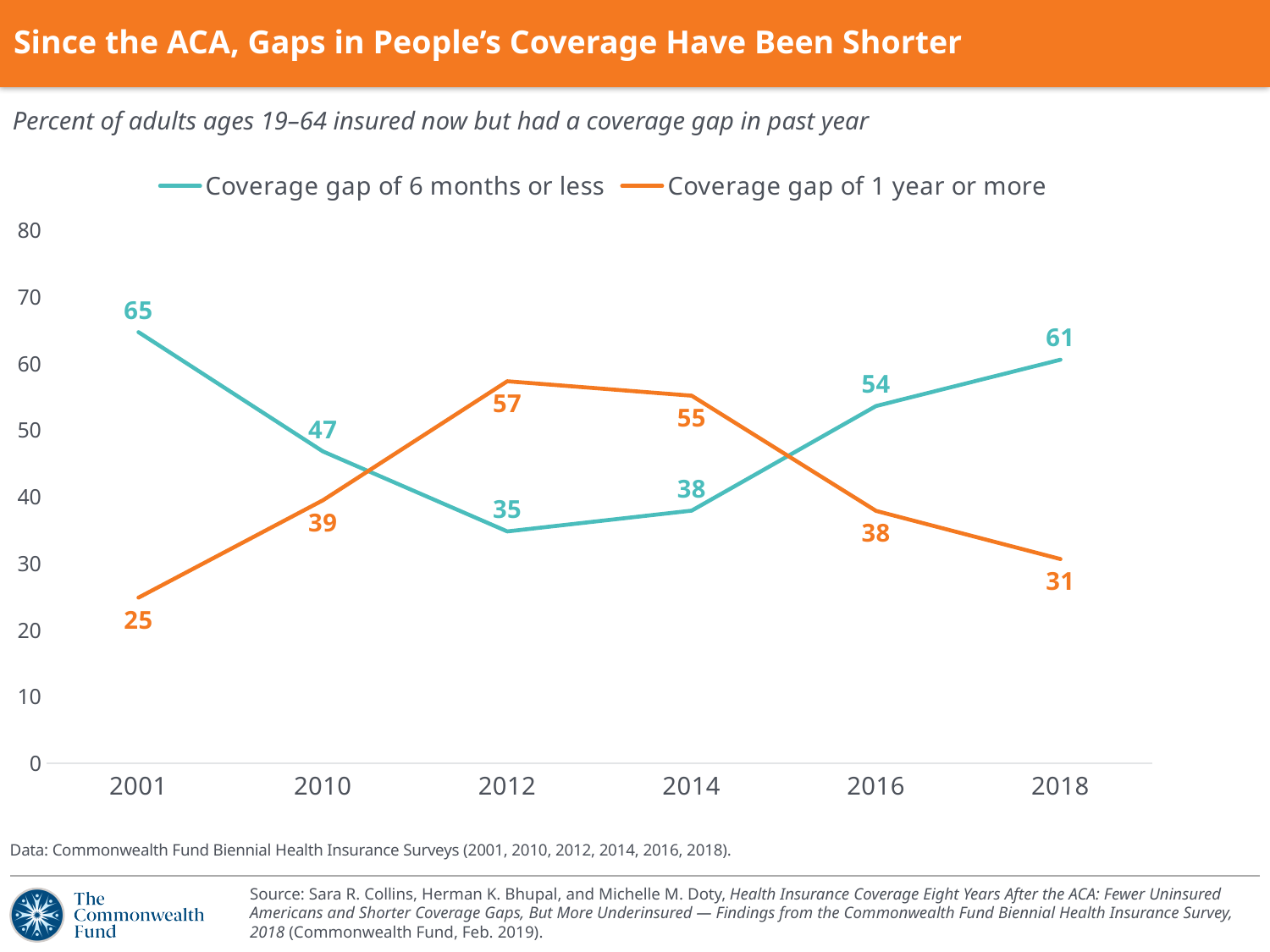
In which year is 'Coverage gap of 1 year or more' highest? 2012 What is the value for 'Coverage gap of 6 months or less' in 2018? 61 Which series has the larger value in 2014? Coverage gap of 1 year or more What kind of chart is shown on the slide? Line chart What is the difference between 'Coverage gap of 6 months or less' and 'Coverage gap of 1 year or more' in 2018? 30 What is the value for 'Coverage gap of 6 months or less' in 2001? 65 What is the value for 'Coverage gap of 1 year or more' in 2012? 57 How many years are shown on the x axis? 6 Does 'Coverage gap of 1 year or more' rise or fall from 2012 to 2018? Fall What colour is the line for 'Coverage gap of 1 year or more'? Orange In which year is 'Coverage gap of 6 months or less' lowest? 2012 How many series does the legend list? 2